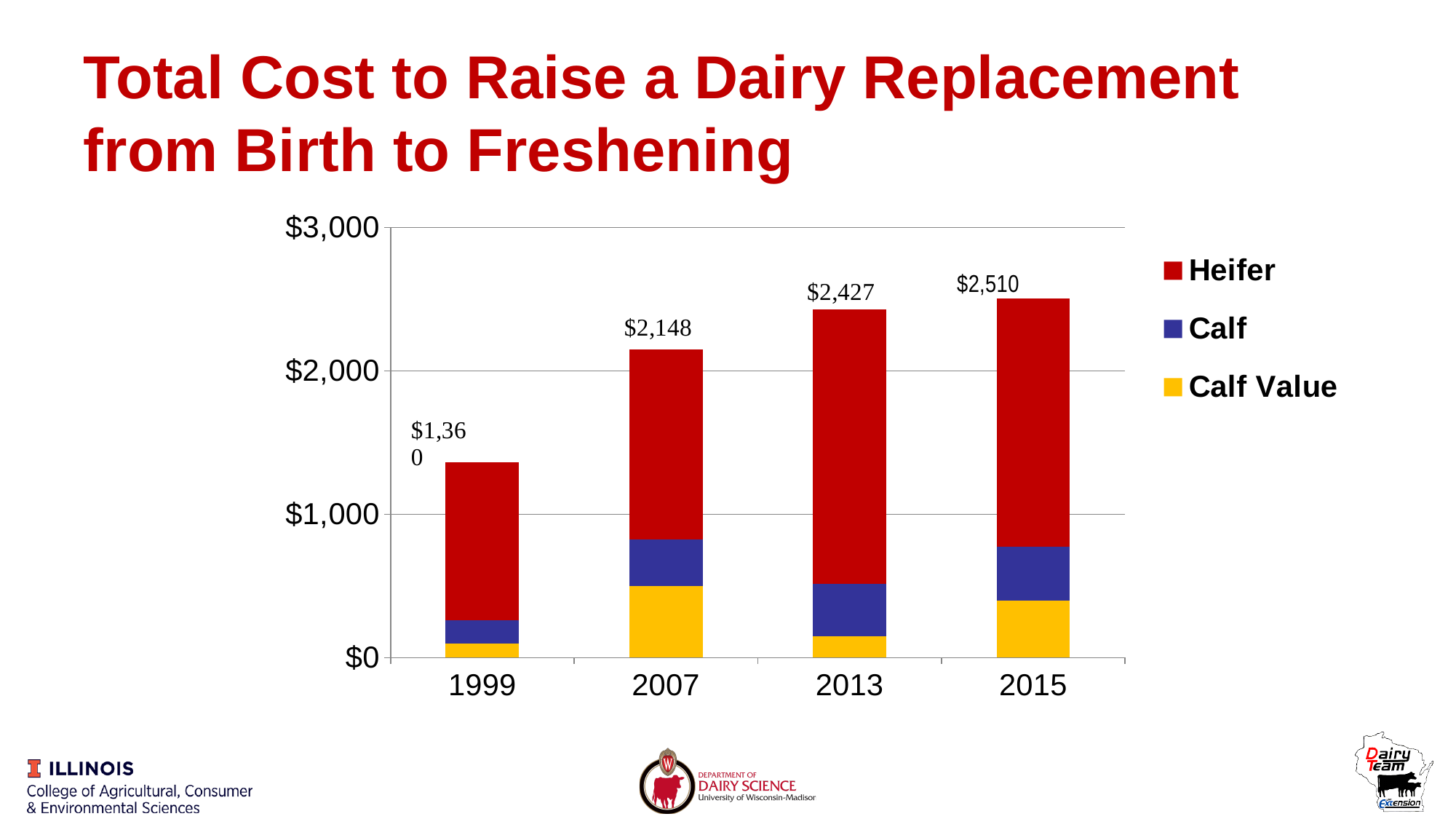
Do the total costs rise or fall from 1999 to 2015? rise What is the difference between the total cost in 2015 and the total cost in 2007? $362 How many years are shown on the x axis? 4 What is the total cost labeled for 2007? $2,148 How many series does the legend list? 3 Is the total cost for 1999 greater or less than $2,000? less Which year has the highest total cost? 2015 What is the total cost labeled for 2015? $2,510 What is the difference between the total cost in 2013 and the total cost in 1999? $1,067 Which year has the lowest total cost? 1999 What is the total cost labeled for 2013? $2,427 Which year has a larger total cost, 2007 or 2013? 2013